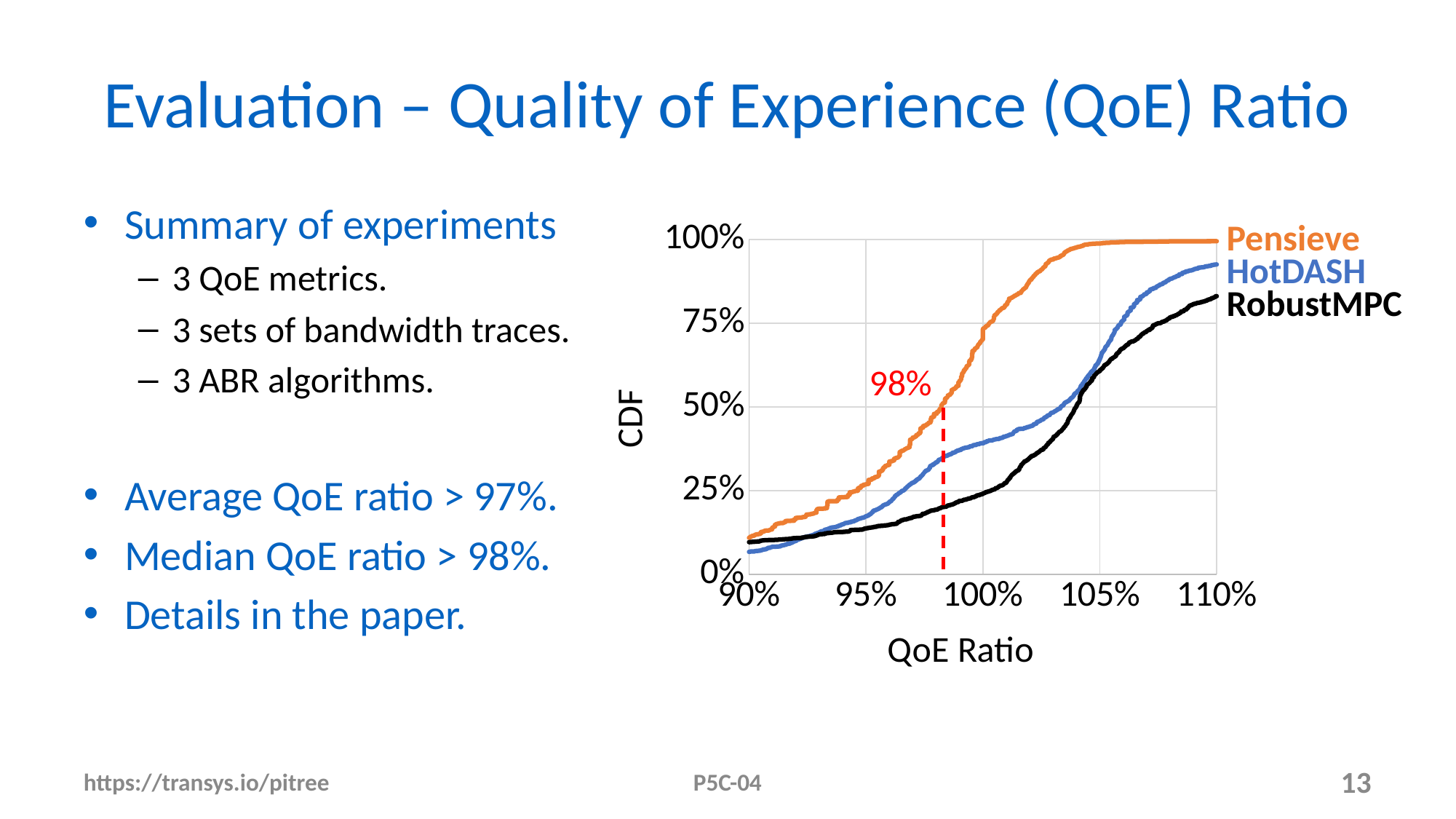
Do the CDF curves rise or fall as the QoE Ratio increases along the x axis? rise Is the CDF value for Pensieve at a QoE Ratio of 105% greater or less than 75%? greater Which series has the lowest CDF value at a QoE Ratio of 110%? RobustMPC Is the CDF value for HotDASH at a QoE Ratio of 110% greater or less than 75%? greater What value does the red dashed vertical line in the chart mark? 98% What kind of chart is shown on the slide? line chart What is the label of the y axis of the chart? CDF How many series (algorithms) are plotted in the chart? 3 At a QoE Ratio of 100%, which series has the higher CDF value, Pensieve or RobustMPC? Pensieve Is the CDF value for Pensieve at a QoE Ratio of 110% greater or less than 75%? greater At a QoE Ratio of 100%, which series has the higher CDF value, HotDASH or RobustMPC? HotDASH